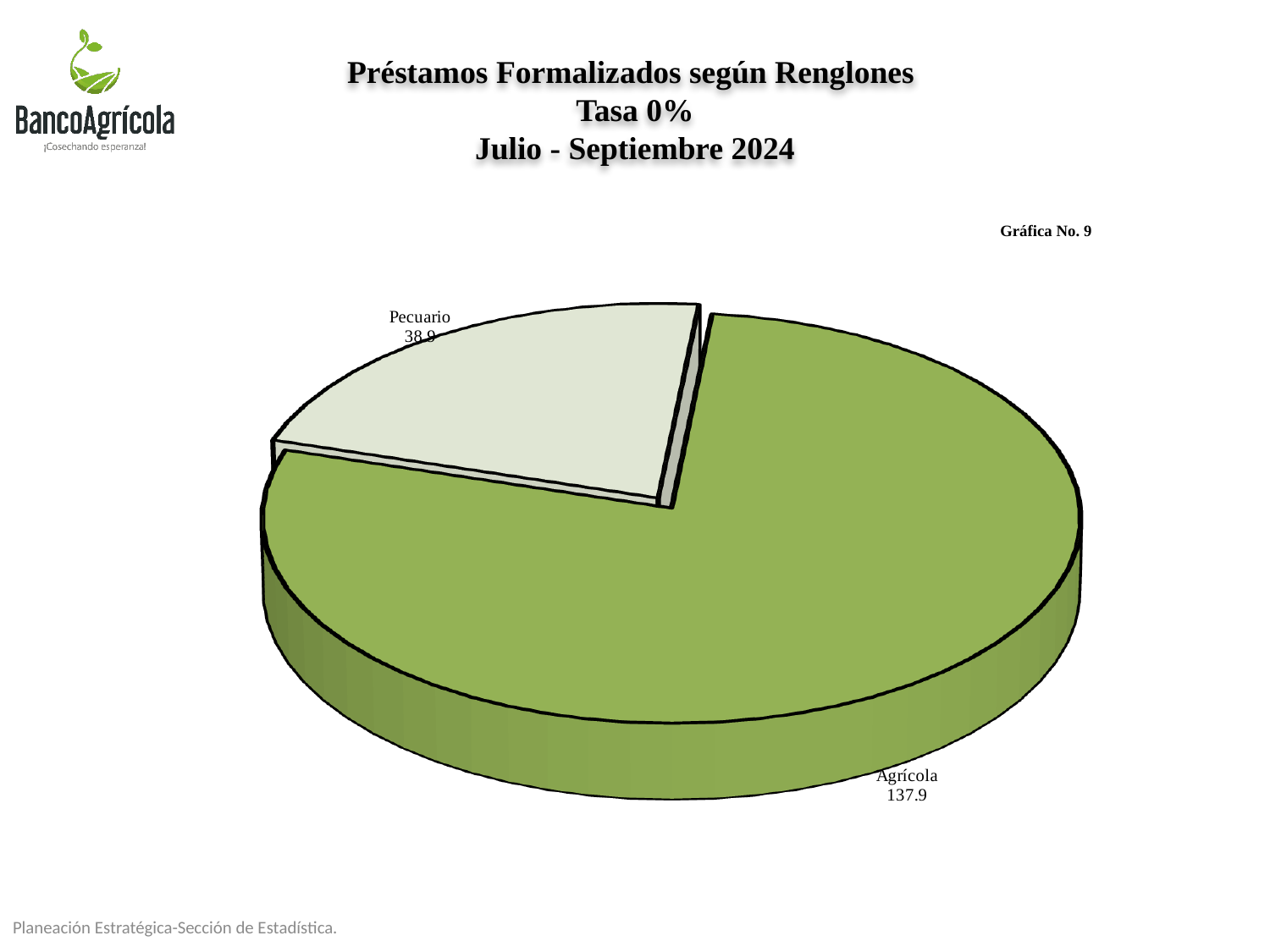
What is the total of the two values shown in the pie chart? 176.8 What is the value shown for Pecuario in the pie chart? 38.9 What graph number is indicated on the slide? Gráfica No. 9 Which category has the largest slice of the pie chart? Agrícola What is the difference between the values for Agrícola and Pecuario? 99.0 How many categories are shown in the pie chart? 2 Which is larger, the value for Agrícola or the value for Pecuario? Agrícola Which category has the smallest slice of the pie chart? Pecuario What is the value shown for Agrícola in the pie chart? 137.9 What kind of chart is shown on the slide? Pie chart What is the title of the chart on the slide? Préstamos Formalizados según Renglones Tasa 0% Julio - Septiembre 2024